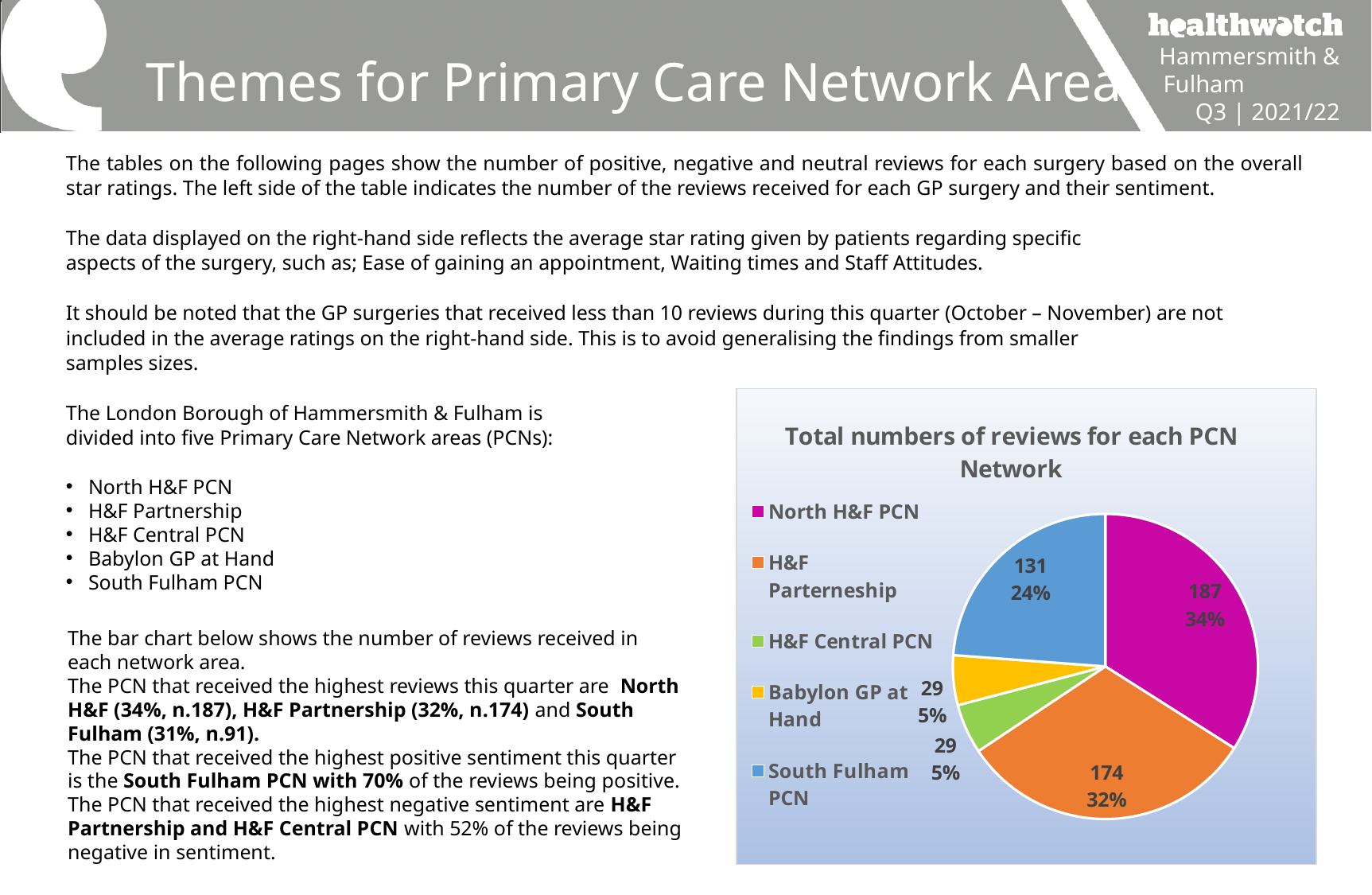
How many reviews does the chart show for South Fulham PCN? 131 Which PCN has the largest slice of the pie chart? North H&F PCN How many reviews does the chart show for H&F Parterneship? 174 What colour is the slice for H&F Parterneship? orange What is the difference in the number of reviews between North H&F PCN and H&F Parterneship? 13 What type of chart is shown on the slide? pie chart What percentage share of reviews does South Fulham PCN have in the pie chart? 24% Which has more reviews, South Fulham PCN or H&F Central PCN? South Fulham PCN How many reviews does the chart show for North H&F PCN? 187 What is the title of the chart? Total numbers of reviews for each PCN Network How many PCN categories does the pie chart show? 5 What percentage share of reviews does Babylon GP at Hand have in the pie chart? 5%